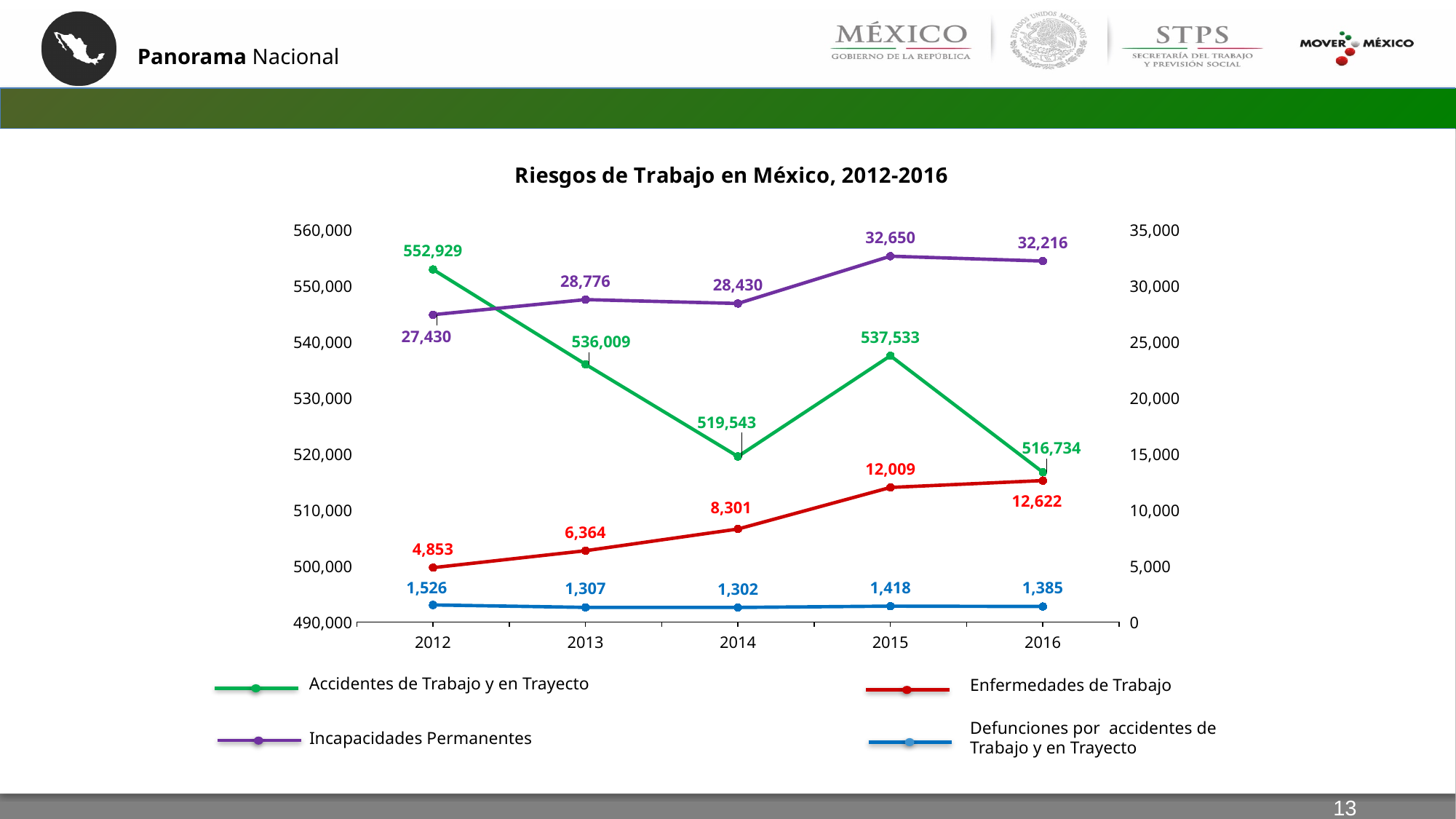
What is the value for Defunciones por accidentes de Trabajo y en Trayecto in 2012? 1,526 How many series does the legend list? 4 What is the value for Incapacidades Permanentes in 2015? 32,650 In which year is Enfermedades de Trabajo lowest? 2012 Does Enfermedades de Trabajo rise or fall from 2012 to 2016? Rise What kind of chart is this? Line chart In which year is Accidentes de Trabajo y en Trayecto highest? 2012 Which is larger, Incapacidades Permanentes in 2013 or in 2014? 2013 What is the value for Accidentes de Trabajo y en Trayecto in 2014? 519,543 What is the value for Enfermedades de Trabajo in 2016? 12,622 How many years are shown on the x axis? 5 What is the difference between the Accidentes de Trabajo y en Trayecto values for 2012 and 2016? 36,195